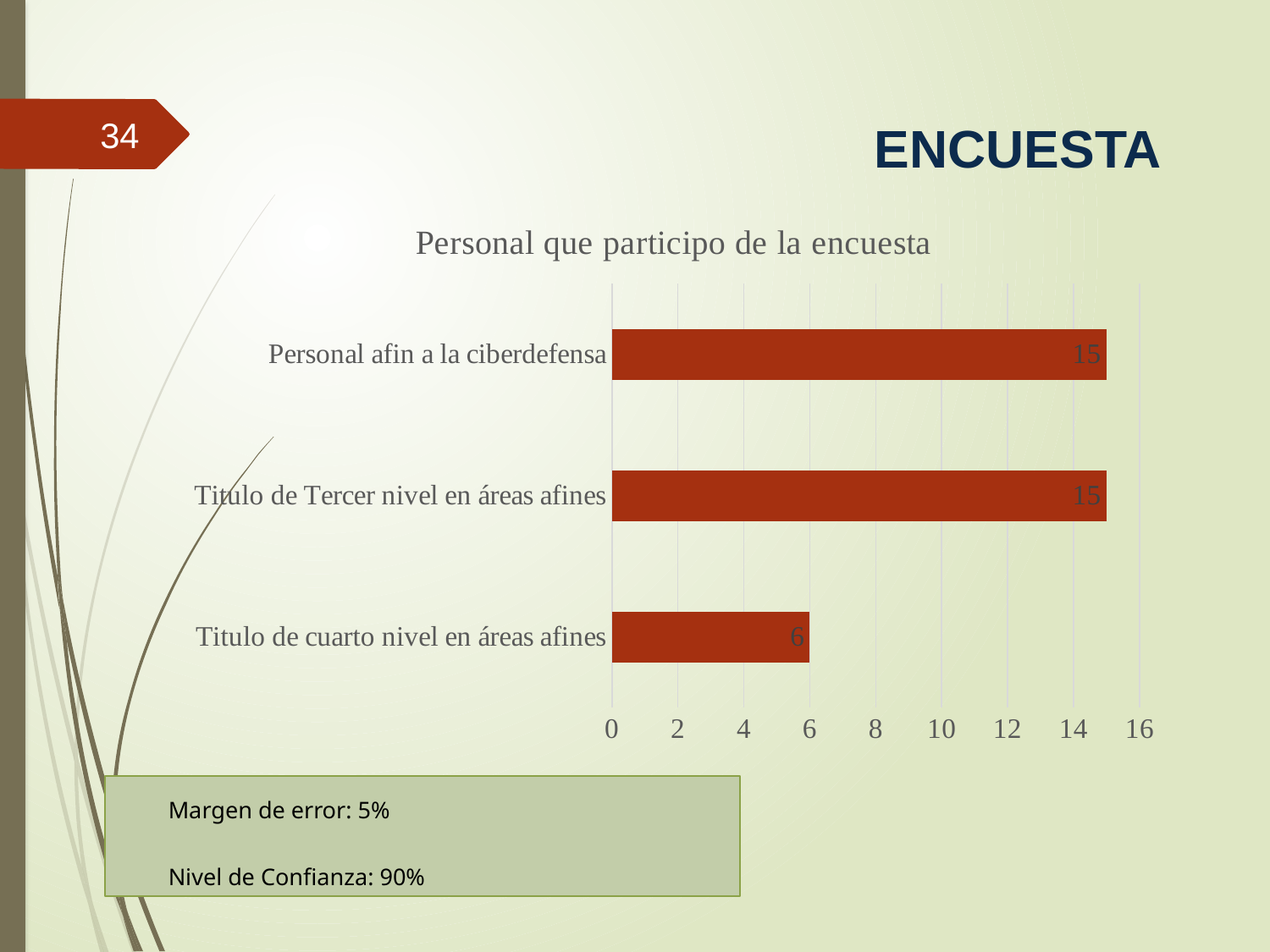
What is the value for "Titulo de cuarto nivel en áreas afines"? 6 What is the value for "Titulo de Tercer nivel en áreas afines"? 15 Is the value for "Titulo de cuarto nivel en áreas afines" greater or less than 10? less Is the value for "Personal afin a la ciberdefensa" greater or less than 12? greater What is the value for "Personal afin a la ciberdefensa"? 15 How many categories are shown in the chart? 3 Which category has the lowest value? Titulo de cuarto nivel en áreas afines What kind of chart is shown on the slide? bar chart What is the difference between the values for "Personal afin a la ciberdefensa" and "Titulo de cuarto nivel en áreas afines"? 9 What is the title of the chart? Personal que participo de la encuesta What is the maximum value shown on the horizontal axis? 16 Which is larger: the value for "Titulo de Tercer nivel en áreas afines" or "Titulo de cuarto nivel en áreas afines"? Titulo de Tercer nivel en áreas afines